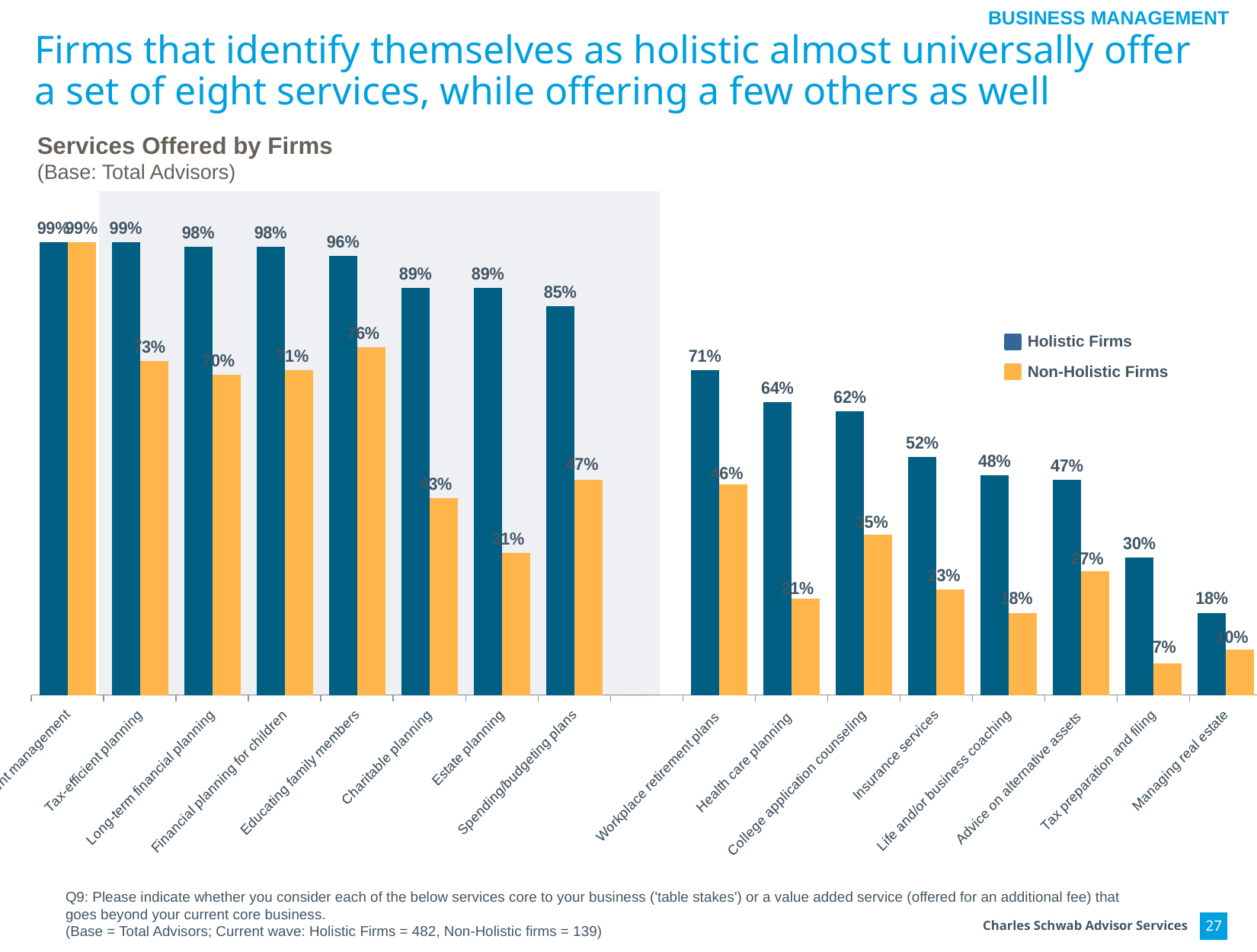
What is the value for Non-Holistic Firms for Tax preparation and filing? 7% What percentage of Non-Holistic Firms offer Health care planning? 21% For Non-Holistic Firms, which is larger: Charitable planning or Estate planning? Charitable planning Do the Holistic Firms values rise or fall from left to right across the x axis? Fall How many series does the legend list? 2 What is the value for Holistic Firms for Workplace retirement plans? 71% What is the difference between Holistic Firms and Non-Holistic Firms for Estate planning? 58 percentage points How many services are shown along the x axis? 16 What kind of chart is shown on the slide? Bar chart What percentage of Holistic Firms offer Estate planning? 89% Which service has the lowest value for Holistic Firms? Managing real estate What is the difference between Holistic Firms and Non-Holistic Firms for Tax preparation and filing? 23 percentage points